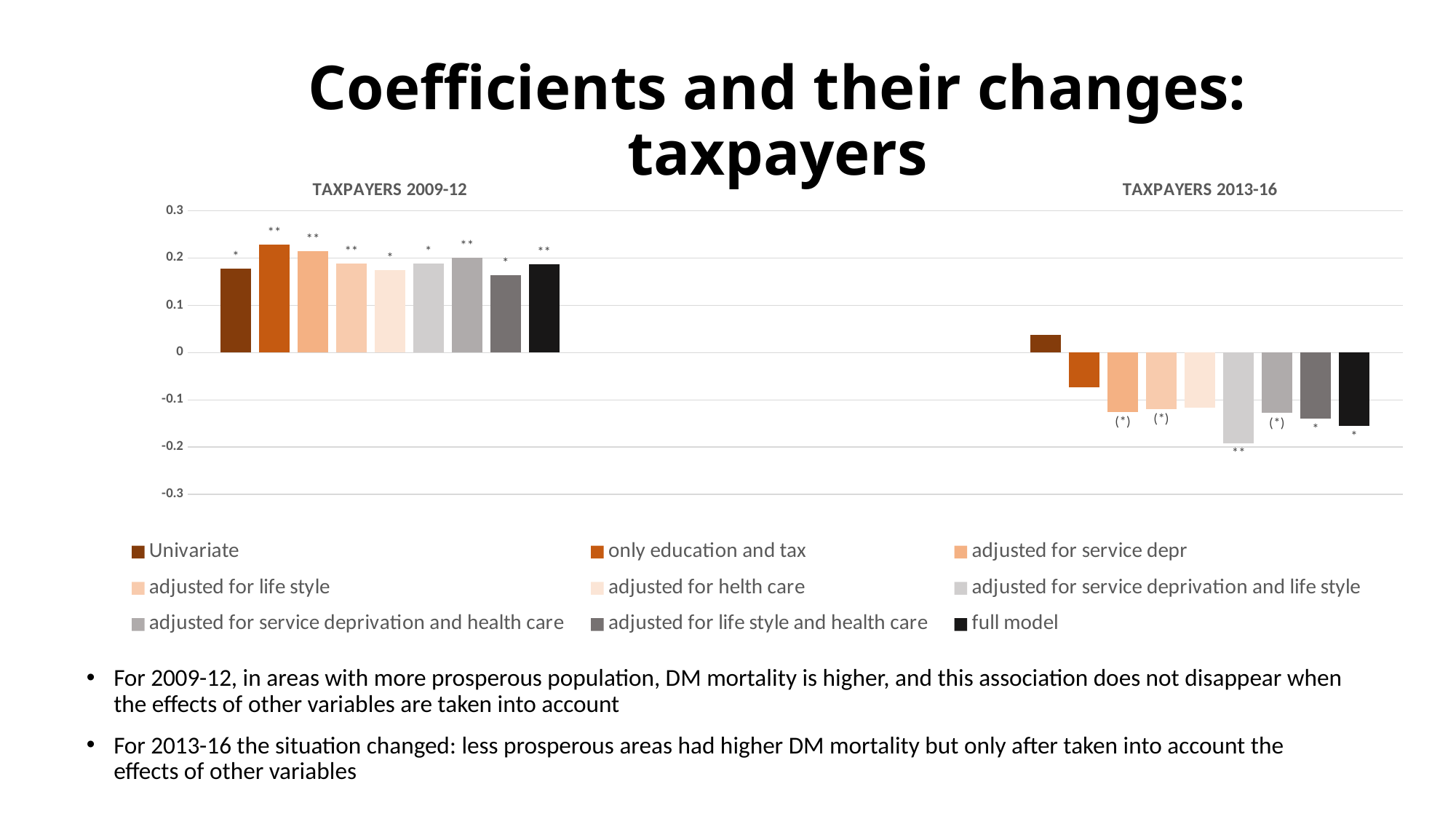
In the TAXPAYERS 2009-12 group, which series has the highest coefficient? only education and tax What kind of chart is shown on the slide? bar chart In the TAXPAYERS 2013-16 group, which series has the lowest coefficient? adjusted for service deprivation and life style Is the 'only education and tax' value for TAXPAYERS 2009-12 greater or less than 0.2? greater Which is larger: the full model coefficient for TAXPAYERS 2009-12 or for TAXPAYERS 2013-16? TAXPAYERS 2009-12 Is the full model value for TAXPAYERS 2013-16 greater or less than -0.1? less What colour is the bar for the full model series? black Is the Univariate value for TAXPAYERS 2009-12 greater or less than 0.1? greater How many series does the legend list? 9 In the TAXPAYERS 2013-16 group, which series has the highest coefficient? Univariate How many groups of bars (periods) are shown on the chart? 2